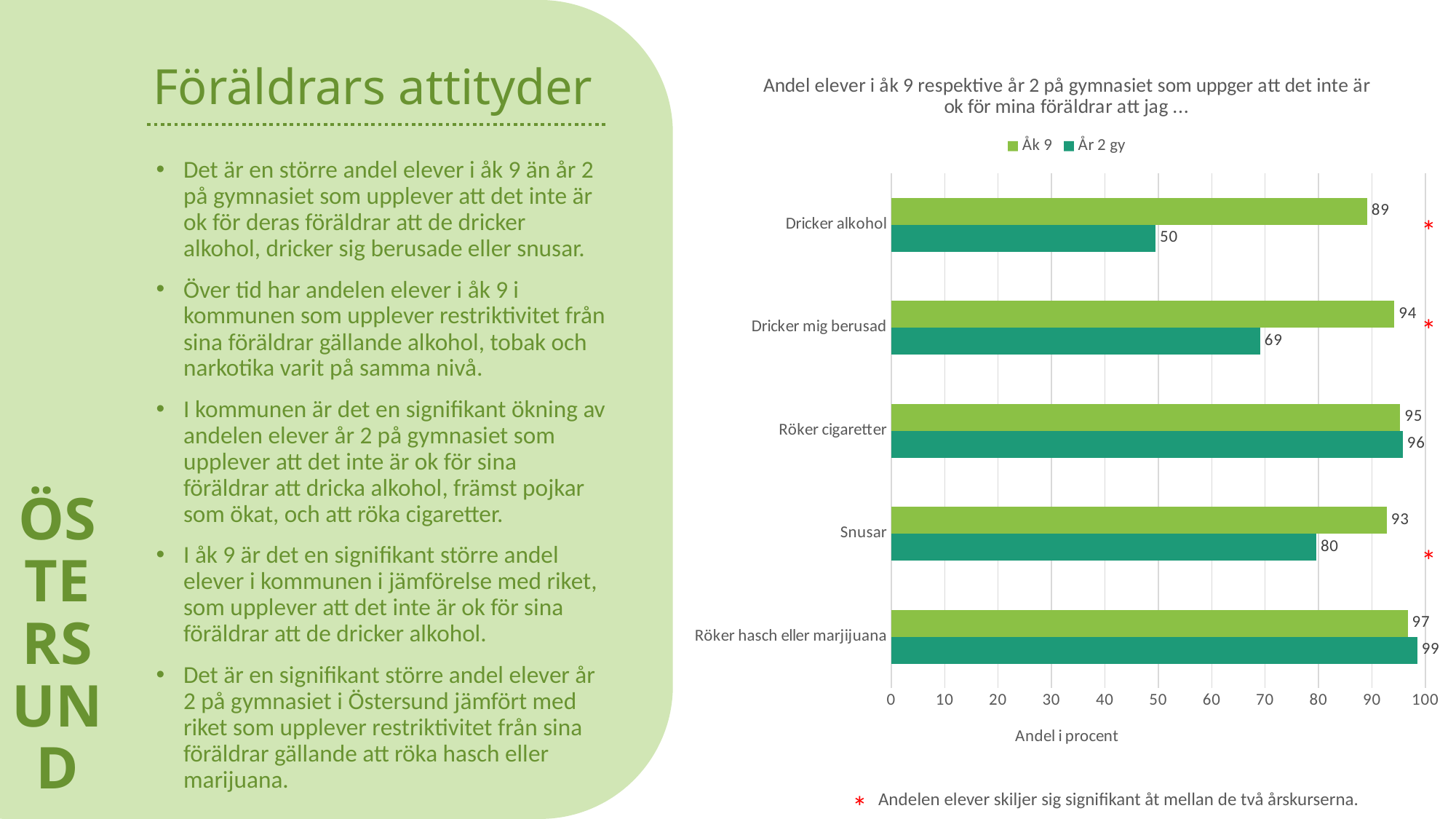
What is the difference between the Åk 9 and År 2 gy values for Dricker alkohol? 39 Which is larger for Snusar: the Åk 9 value or the År 2 gy value? Åk 9 Which category has the highest value for Åk 9? Röker hasch eller marjijuana How many series does the legend list? 2 How many categories are shown on the chart? 5 Which category has the lowest value for År 2 gy? Dricker alkohol What is the difference between the Åk 9 and År 2 gy values for Dricker mig berusad? 25 What is the value for År 2 gy in the Snusar category? 80 What is the label of the horizontal axis of the chart? Andel i procent What is the value for År 2 gy in the Dricker mig berusad category? 69 What is the value for Åk 9 in the Dricker alkohol category? 89 What kind of chart is shown on the slide? Bar chart